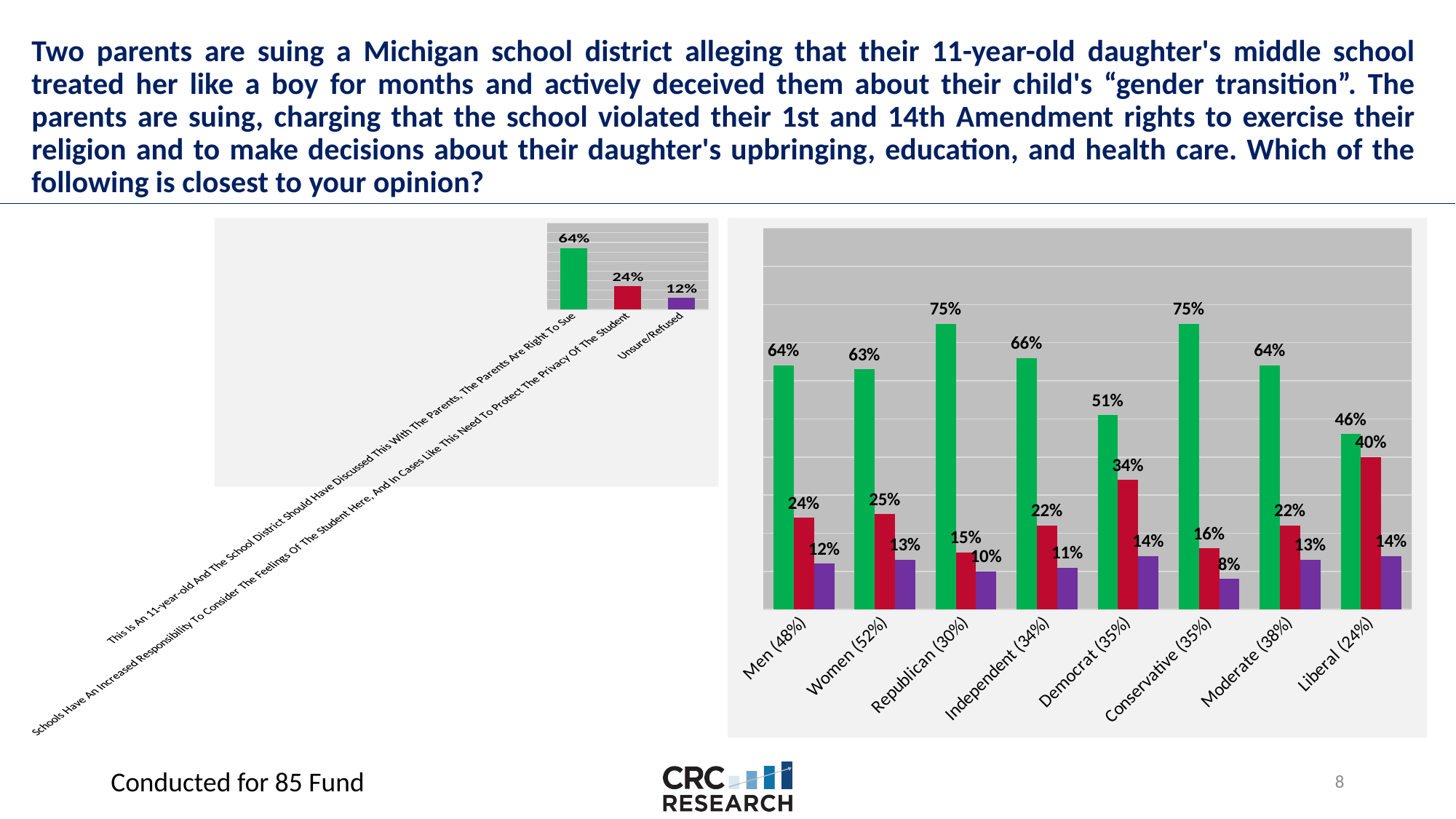
In the right chart, which group has the lowest green bar? Liberal (24%) In the right chart, what is the value of the green bar for Republican (30%)? 75% What kind of chart is the right chart? Bar chart In the right chart, what is the value of the purple bar for Conservative (35%)? 8% In the left chart, what is the value for Unsure/Refused? 12% In the left chart, which category has the highest value? This Is An 11-year-old And The School District Should Have Discussed This With The Parents, The Parents Are Right To Sue How many bars does the left chart show? 3 How many demographic groups are shown on the x axis of the right chart? 8 In the right chart, is the green bar for Democrat (35%) larger or smaller than the green bar for Independent (34%)? Smaller In the right chart, what is the value of the red bar for Liberal (24%)? 40% In the left chart, what is the difference between the highest bar (64%) and the Unsure/Refused bar? 52 percentage points In the right chart, which group has the highest red bar? Liberal (24%)